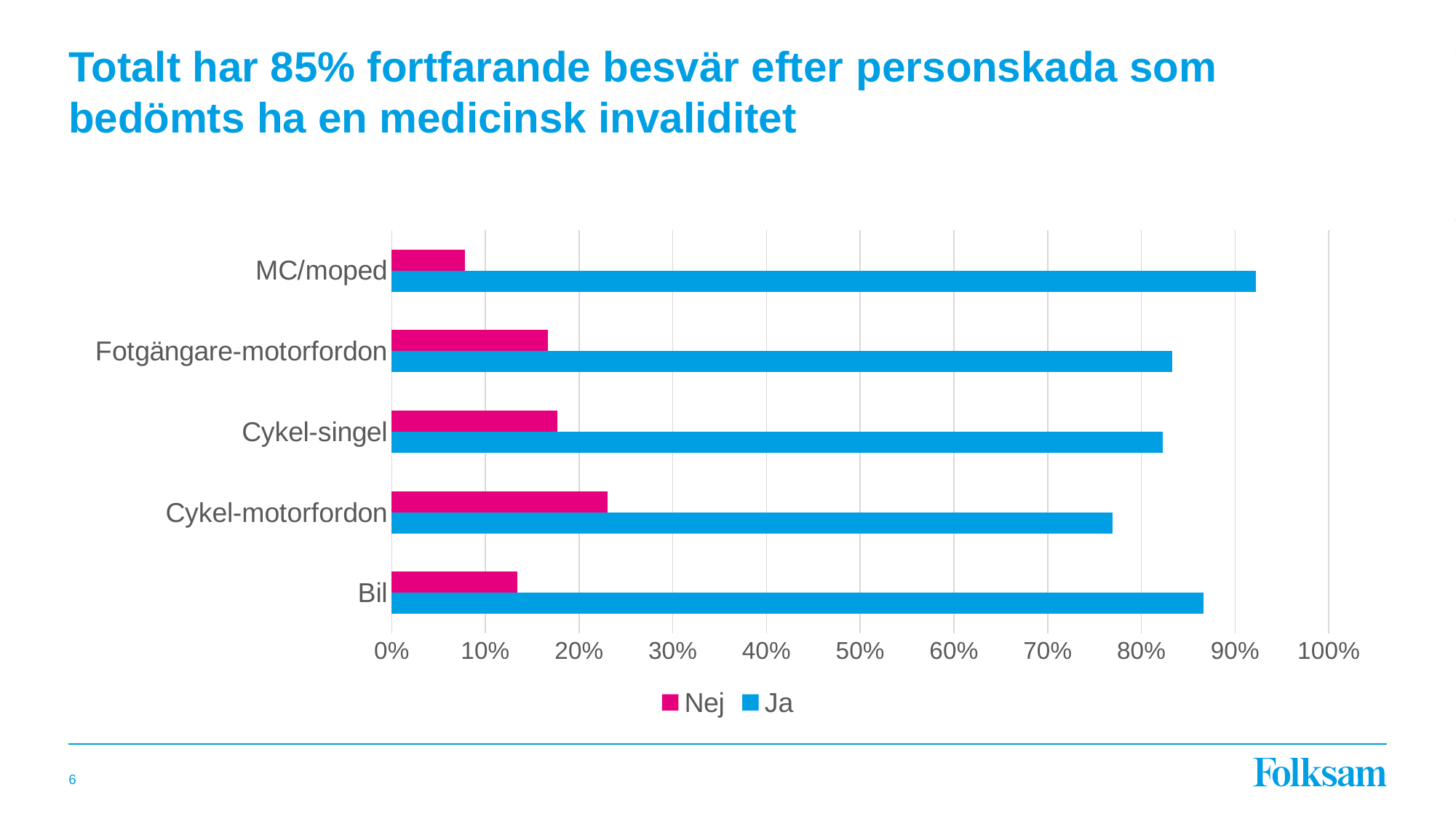
Which category has the highest value for Ja? MC/moped Which category has the highest value for Nej? Cykel-motorfordon How many categories are shown on the chart? 5 Is the Nej value for Bil greater or less than 10%? greater Which category has the lowest value for Nej? MC/moped Is the Ja value for MC/moped greater or less than 90%? greater What colour are the Nej bars? pink Is the Ja value for Cykel-motorfordon greater or less than 80%? less What kind of chart is shown on the slide? bar chart Which is larger, the Ja value for Bil or the Ja value for Cykel-singel? Bil Which category has the lowest value for Ja? Cykel-motorfordon How many series does the legend list? 2